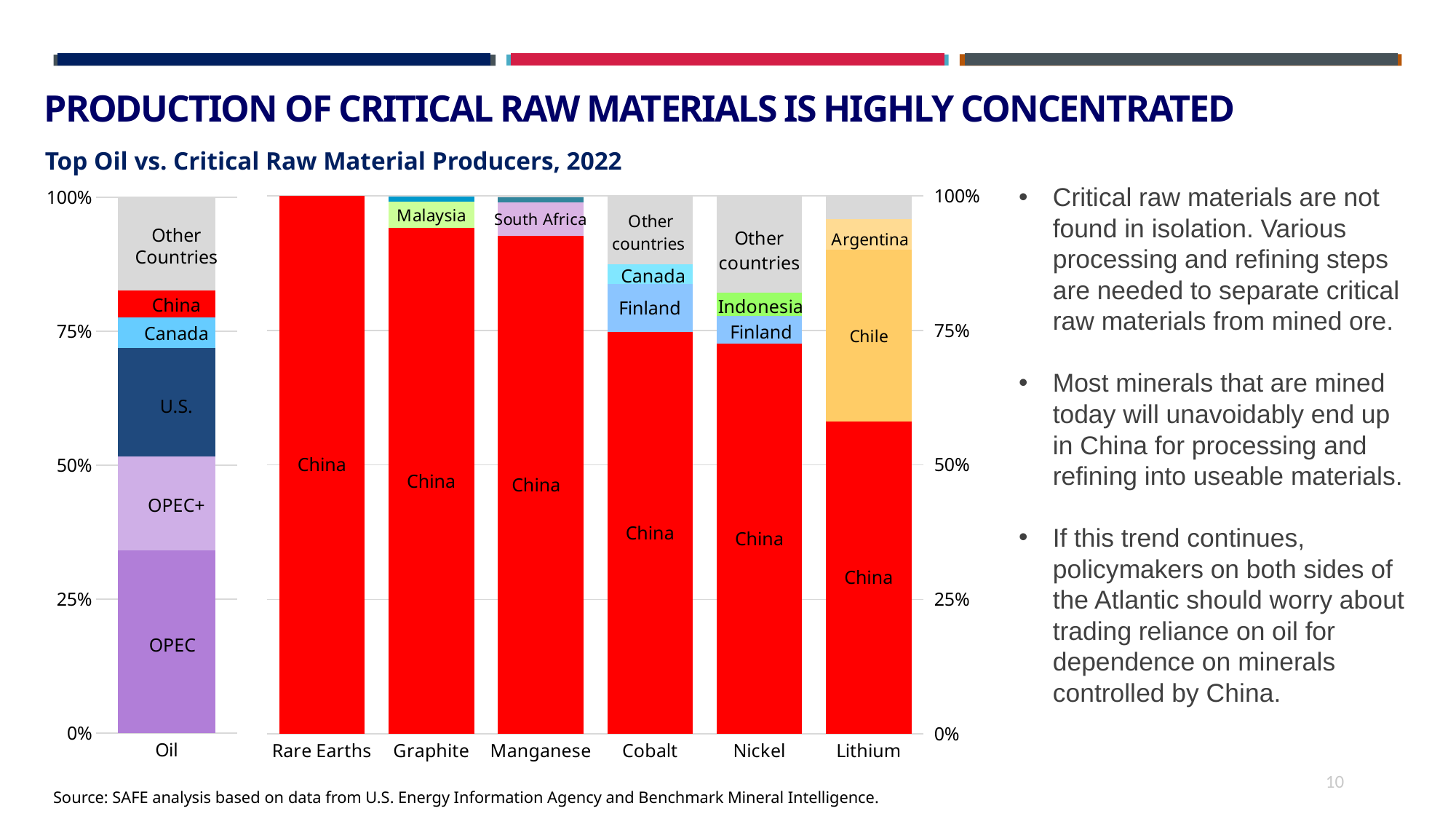
In the critical raw materials chart, which material has the smallest China share? Lithium In the Oil chart (left), is the OPEC share greater or less than 25%? greater In the critical raw materials chart, is Chile's share of Lithium greater or less than 25%? greater In the Oil chart (left), is the U.S. share greater or less than 25%? less In the critical raw materials chart, is China's share larger for Rare Earths or for Lithium? Rare Earths In the critical raw materials chart, which material has the largest China share? Rare Earths In the critical raw materials chart, which country other than China is labelled in the Graphite bar? Malaysia What kind of chart is used to show the producer shares on this slide? Stacked bar chart In the Oil chart (left), which producer segment is the largest? OPEC In the critical raw materials chart (right), how many materials are shown on the x axis? 6